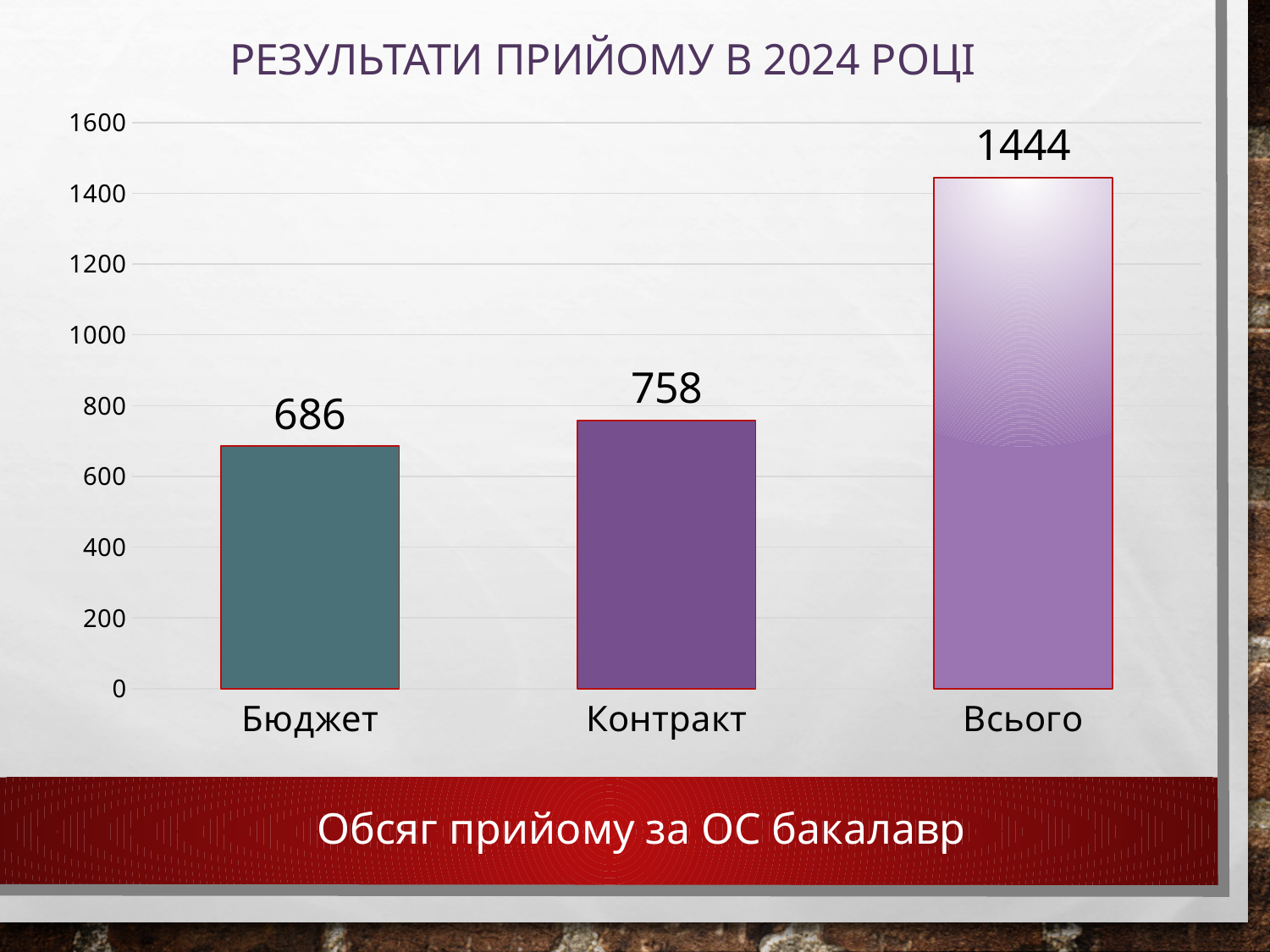
Which is larger, the value for Бюджет or the value for Контракт? Контракт What is the difference between the values for Контракт and Бюджет? 72 What kind of chart is shown on the slide? bar chart What is the difference between the values for Всього and Контракт? 686 Which category has the lowest value? Бюджет What is the title of the slide above the chart? РЕЗУЛЬТАТИ ПРИЙОМУ В 2024 РОЦІ What is the value for Всього? 1444 What is the value for Бюджет? 686 How many categories are shown on the x axis? 3 Is the value for Всього greater or less than 1400? greater What is the value for Контракт? 758 Which category has the highest value? Всього